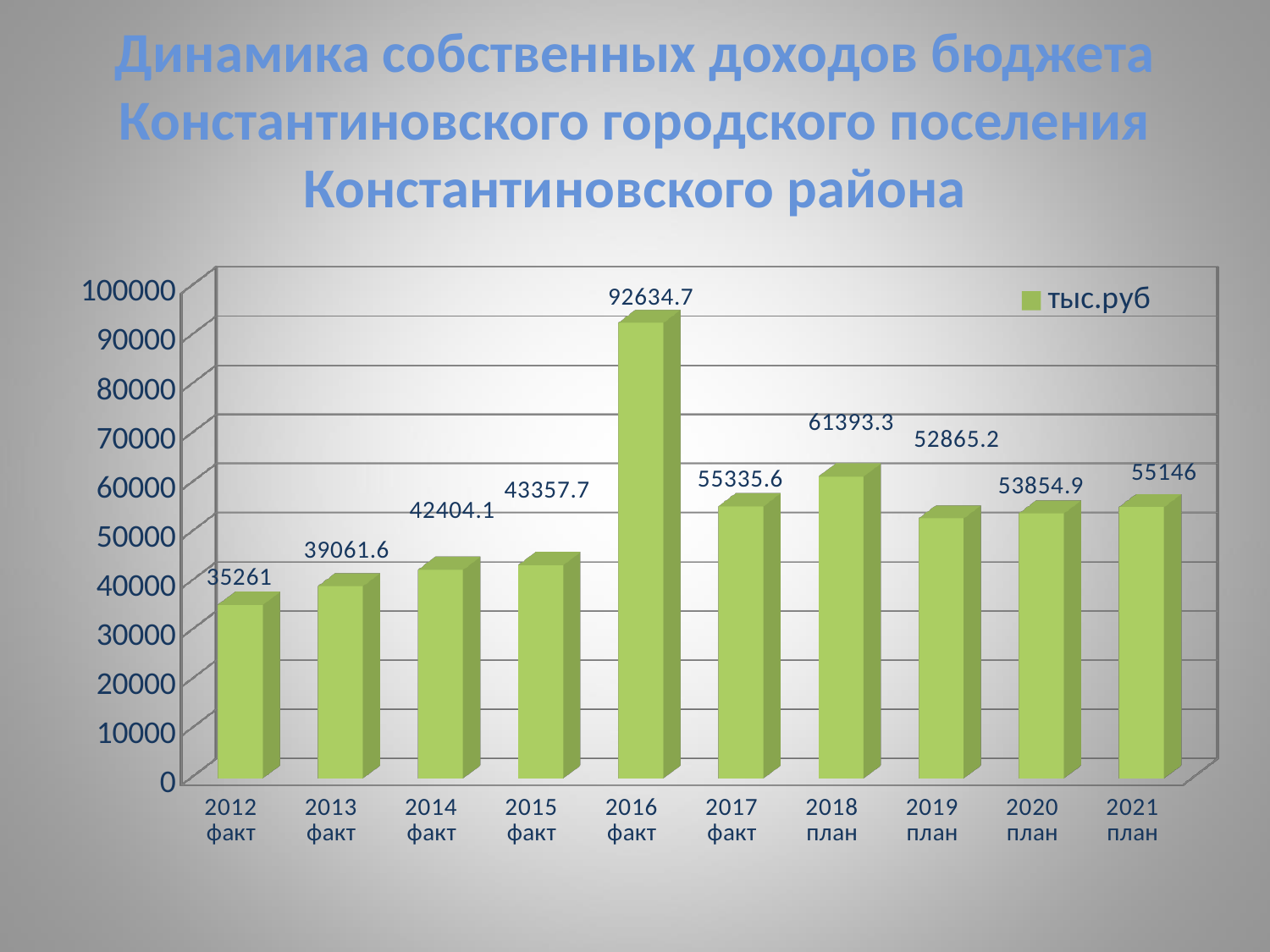
What series name does the legend show? тыс.руб Which is larger, the value for 2018 план or the value for 2021 план? 2018 план What is the difference between the values for 2016 факт and 2012 факт? 57373.7 What is the value for 2019 план? 52865.2 What is the value for 2016 факт? 92634.7 Is the value for 2015 факт greater or less than 50000? less What kind of chart is shown on the slide? bar chart What is the value for 2012 факт? 35261 How many categories are shown on the x axis? 10 What is the difference between the values for 2018 план and 2017 факт? 6057.7 Which category has the lowest value? 2012 факт Which category has the highest value? 2016 факт